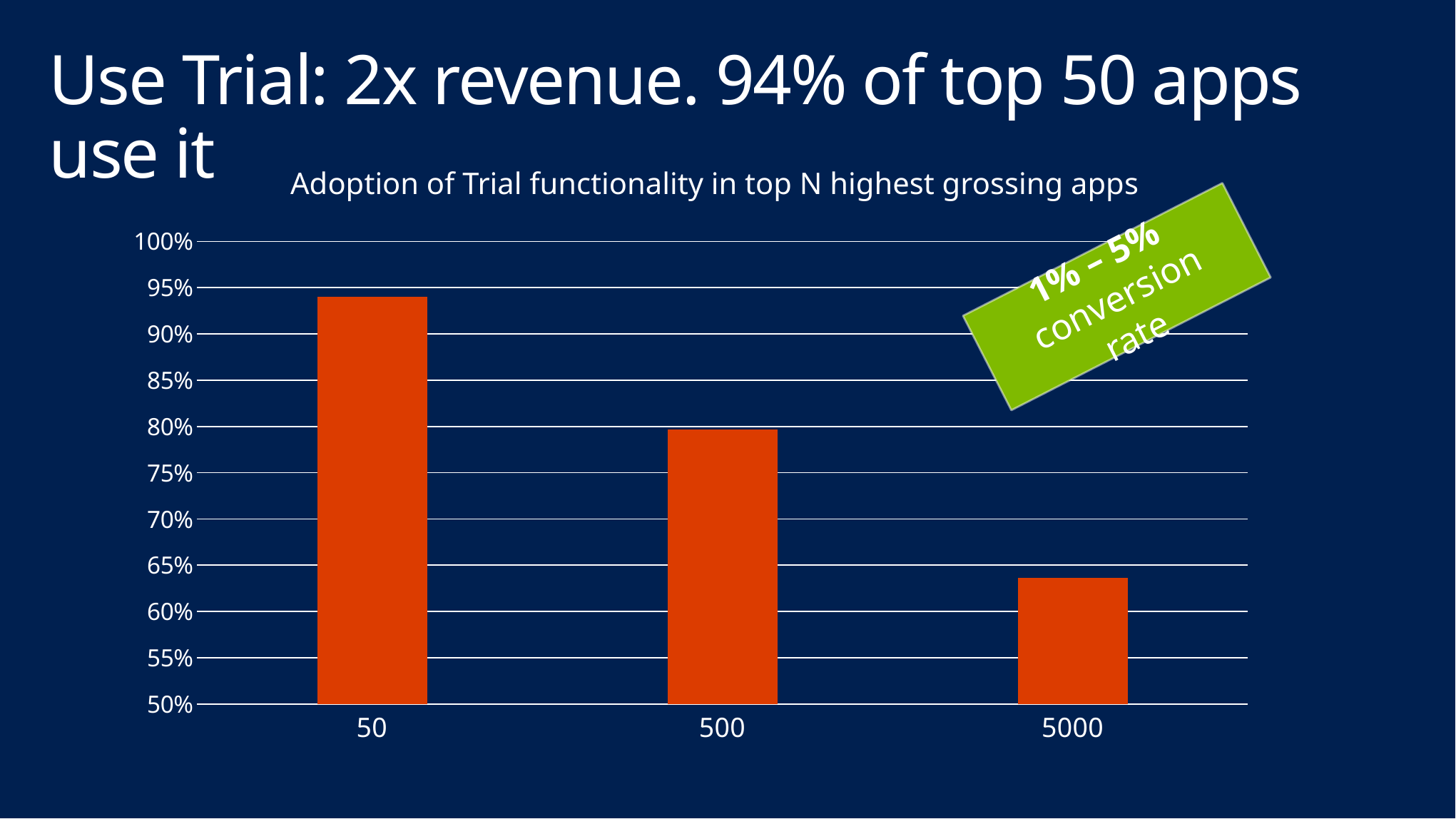
Which category has the highest adoption of Trial functionality? 50 How many categories are shown on the x axis of the chart? 3 Is the value for 5000 greater or less than 65%? less Is the value for 5000 greater or less than 60%? greater What kind of chart is shown on the slide? bar chart Which has a higher value, 50 or 5000? 50 Which category has the lowest adoption of Trial functionality? 5000 Is the value for 500 greater or less than 75%? greater What is the adoption of Trial functionality for the top 50 apps? 94% What is the title of the chart? Adoption of Trial functionality in top N highest grossing apps Do the values rise or fall as N increases along the x axis? fall